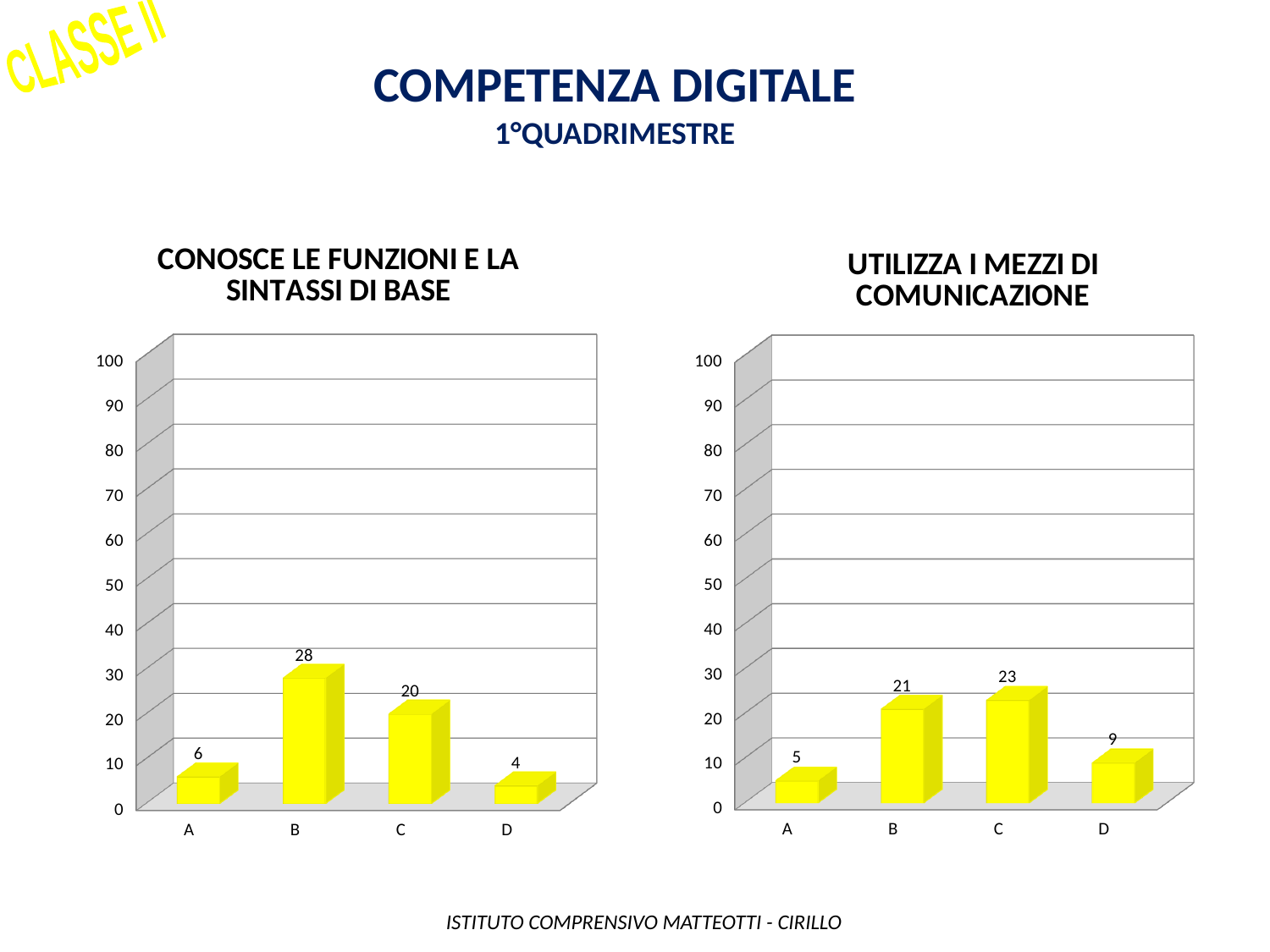
In the chart titled 'CONOSCE LE FUNZIONI E LA SINTASSI DI BASE', which category has the highest value? B In the chart titled 'UTILIZZA I MEZZI DI COMUNICAZIONE', what is the value for category D? 9 How many categories are shown in the chart titled 'UTILIZZA I MEZZI DI COMUNICAZIONE'? 4 What kind of chart is the chart titled 'CONOSCE LE FUNZIONI E LA SINTASSI DI BASE'? bar chart In the chart titled 'UTILIZZA I MEZZI DI COMUNICAZIONE', which category has the lowest value? A In the chart titled 'UTILIZZA I MEZZI DI COMUNICAZIONE', which is larger, the value for B or the value for C? C In the chart titled 'CONOSCE LE FUNZIONI E LA SINTASSI DI BASE', what is the value for category B? 28 In the chart titled 'UTILIZZA I MEZZI DI COMUNICAZIONE', what is the value for category A? 5 In the chart titled 'CONOSCE LE FUNZIONI E LA SINTASSI DI BASE', what is the difference between the values for B and C? 8 What is the main title at the top of the slide? COMPETENZA DIGITALE In the chart titled 'CONOSCE LE FUNZIONI E LA SINTASSI DI BASE', which category has the lowest value? D In the chart titled 'CONOSCE LE FUNZIONI E LA SINTASSI DI BASE', is the value for C greater or less than 30? less